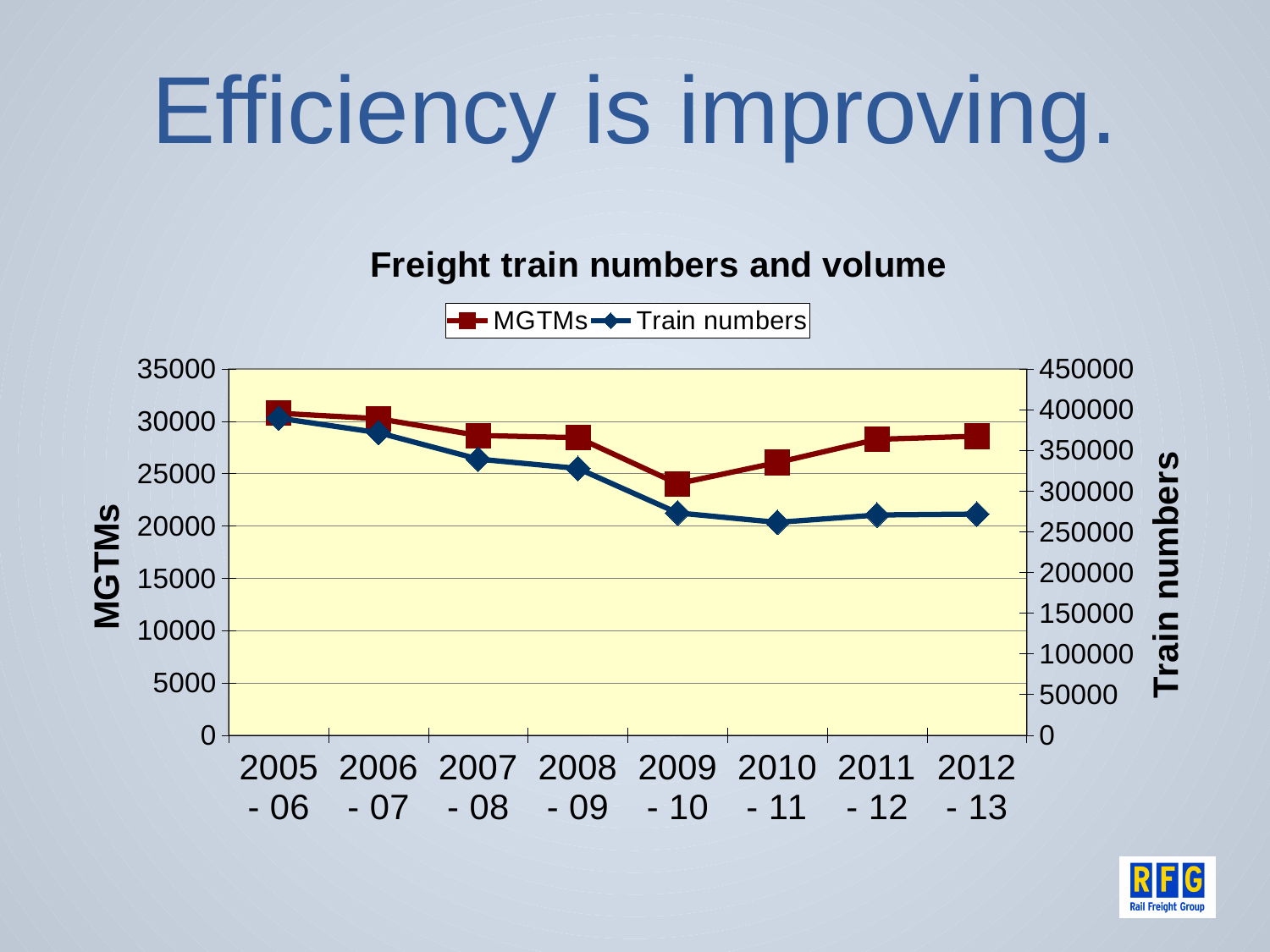
In which year are MGTMs lowest? 2009 - 10 In which year are train numbers lowest? 2010 - 11 Is the train numbers value for 2010 - 11 greater or less than 300000? less How many series does the legend list? 2 How many years are plotted along the x axis? 8 What kind of chart is shown on the slide? line chart In which year are MGTMs highest? 2005 - 06 Is the train numbers value for 2005 - 06 greater or less than 350000? greater Do train numbers rise or fall from 2005 - 06 to 2010 - 11? fall Which year has the larger train numbers value, 2007 - 08 or 2011 - 12? 2007 - 08 In which year are train numbers highest? 2005 - 06 Is the MGTMs value for 2009 - 10 greater or less than 25000? less